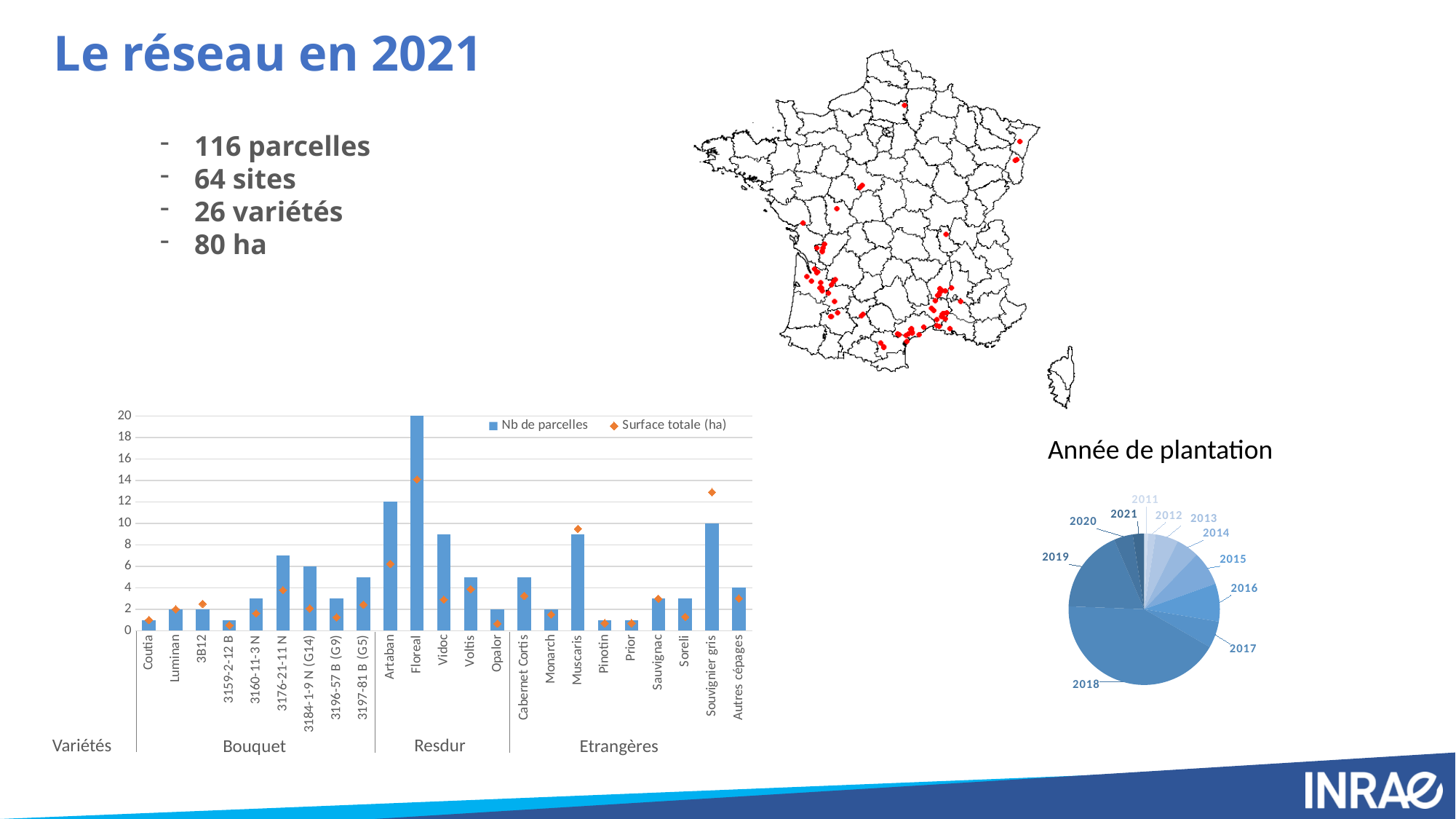
In the bar chart at the bottom left, which variety has the highest number of parcelles? Floreal In the bar chart at the bottom left, what is the number of parcelles for Artaban? 12 In the bar chart at the bottom left, is the number of parcelles for Muscaris greater or less than 8? greater In the bar chart at the bottom left, what is the number of parcelles (Nb de parcelles) for Floreal? 20 In the bar chart at the bottom left, what is the number of parcelles for Souvignier gris? 10 In the bar chart at the bottom left, what is the difference in number of parcelles between Floreal and Artaban? 8 What kind of chart is the 'Année de plantation' chart? Pie chart In the bar chart at the bottom left, which has more parcelles, Artaban or Vidoc? Artaban How many series does the legend of the bar chart at the bottom left list? 2 In the bar chart at the bottom left, is the number of parcelles for 3176-21-11 N greater or less than 6? greater In the 'Année de plantation' pie chart, which year has the largest slice? 2018 What are the three variety groups labelled under the x axis of the bar chart at the bottom left? Bouquet, Resdur, Etrangères